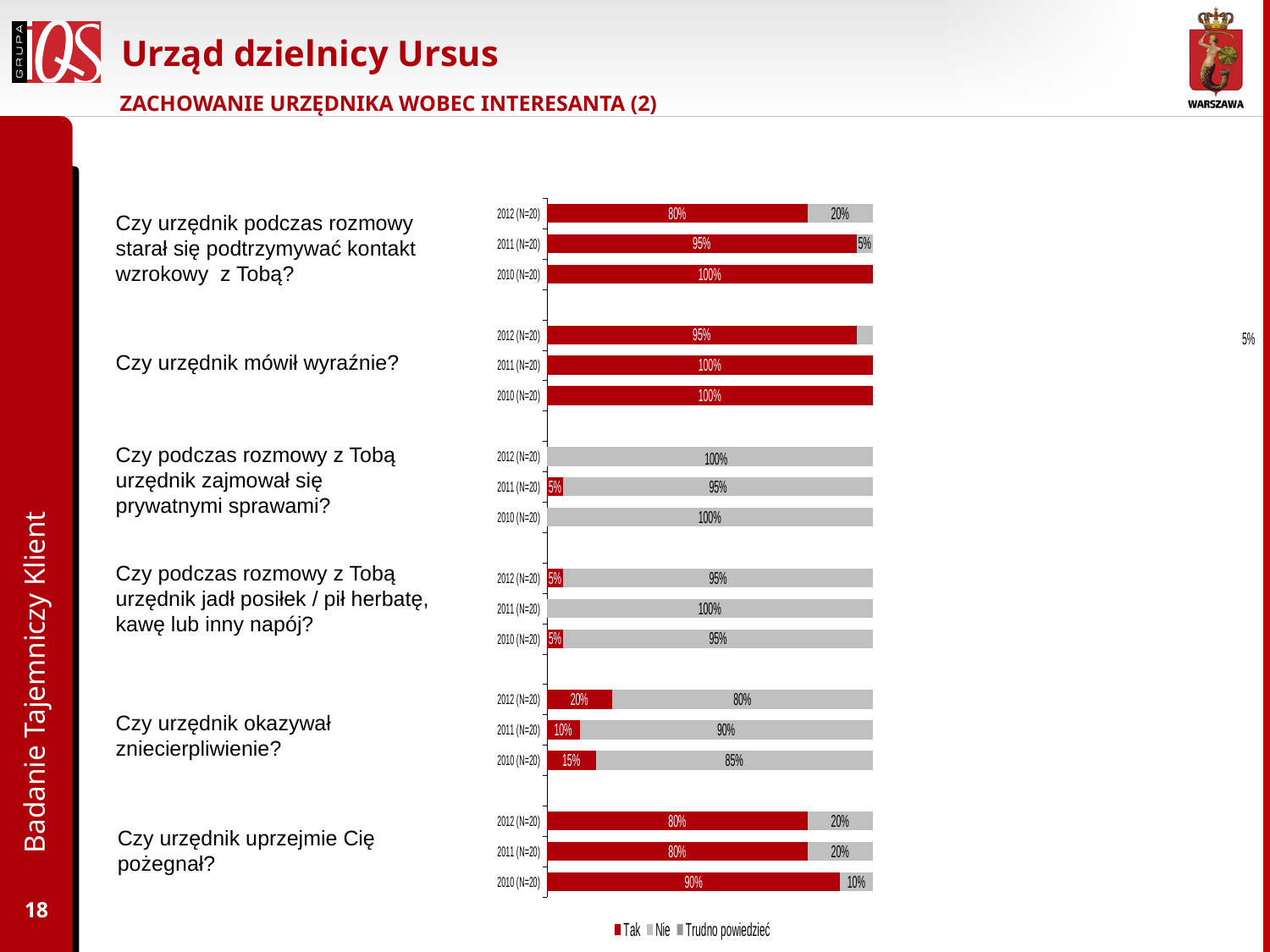
What kind of chart is shown on the slide? Stacked bar chart In the chart, what is the "Tak" value for 2010 (N=20) for "Czy urzędnik uprzejmie Cię pożegnał?"? 90% For "Czy urzędnik podczas rozmowy starał się podtrzymywać kontakt wzrokowy z Tobą?", what is the difference in the "Tak" share between 2010 (N=20) and 2012 (N=20)? 20 percentage points In the chart, what is the "Tak" value for 2012 (N=20) for "Czy urzędnik mówił wyraźnie?"? 95% In the chart, what percentage answered "Nie" in 2011 (N=20) for "Czy urzędnik podczas rozmowy starał się podtrzymywać kontakt wzrokowy z Tobą?"? 5% In the chart, what percentage answered "Tak" in 2012 (N=20) for "Czy urzędnik podczas rozmowy starał się podtrzymywać kontakt wzrokowy z Tobą?"? 80% What are the three legend entries of the chart? Tak, Nie, Trudno powiedzieć How many series does the chart's legend list? 3 For "Czy urzędnik okazywał zniecierpliwienie?", which year has the larger "Tak" share: 2012 (N=20) or 2011 (N=20)? 2012 (N=20) In the chart, what is the "Nie" value for 2010 (N=20) for "Czy urzędnik okazywał zniecierpliwienie?"? 85% In the chart, what is the "Tak" value for 2012 (N=20) for "Czy podczas rozmowy z Tobą urzędnik jadł posiłek / pił herbatę, kawę lub inny napój?"? 5% In the chart, what is the "Tak" value for 2012 (N=20) for "Czy urzędnik okazywał zniecierpliwienie?"? 20%